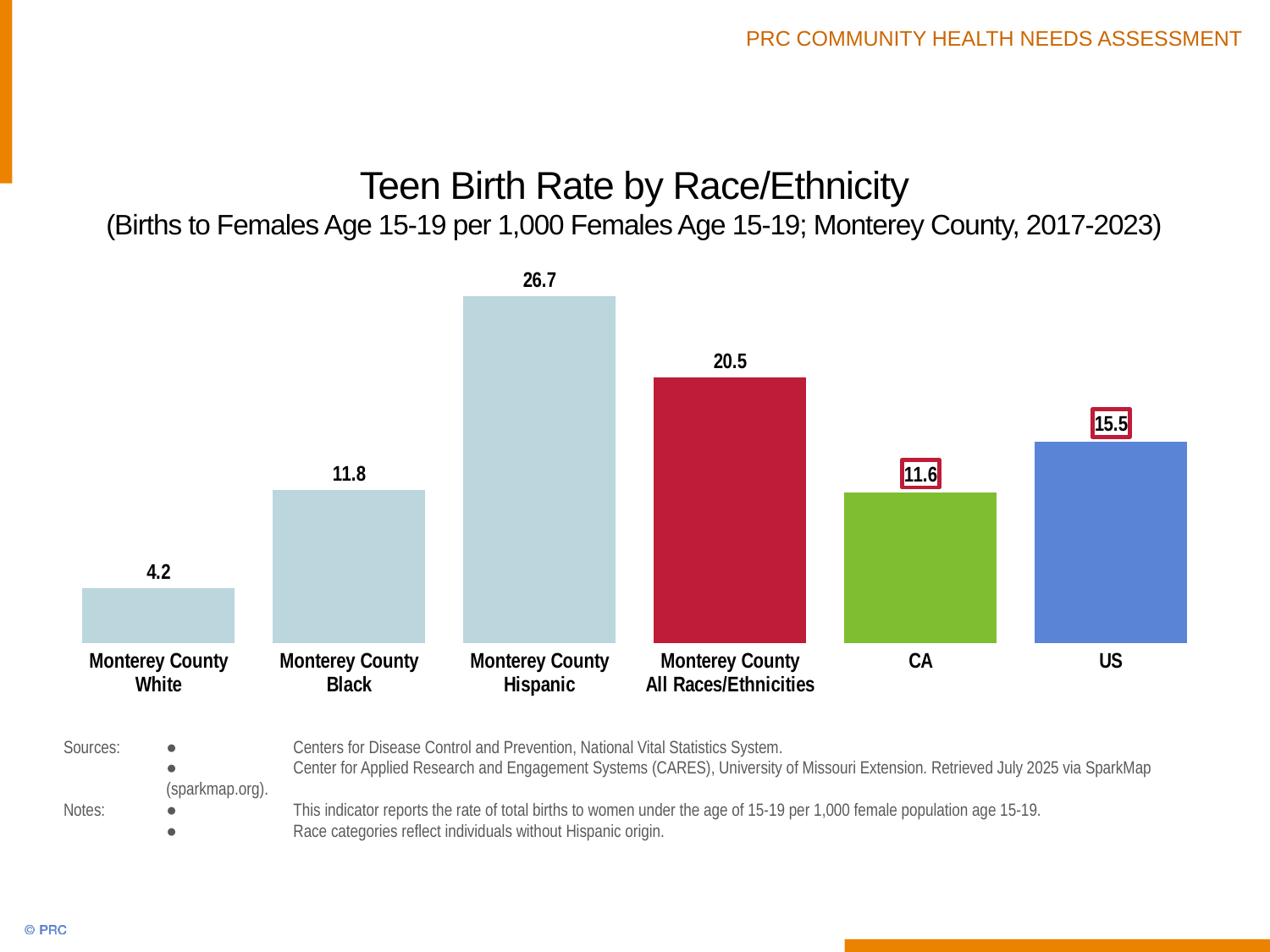
What kind of chart is shown on the slide? Bar chart What is the teen birth rate for the US? 15.5 Which category has the highest teen birth rate? Monterey County Hispanic What is the difference between the teen birth rate for Monterey County Black and Monterey County White? 7.6 What is the teen birth rate for Monterey County White? 4.2 What is the teen birth rate for CA? 11.6 What is the title of the chart? Teen Birth Rate by Race/Ethnicity What is the difference between the teen birth rate for Monterey County All Races/Ethnicities and the US? 5.0 How many categories are shown in the chart? 6 Which category has the lowest teen birth rate? Monterey County White What is the teen birth rate for Monterey County Hispanic? 26.7 Which is larger, the teen birth rate for Monterey County Black or for CA? Monterey County Black